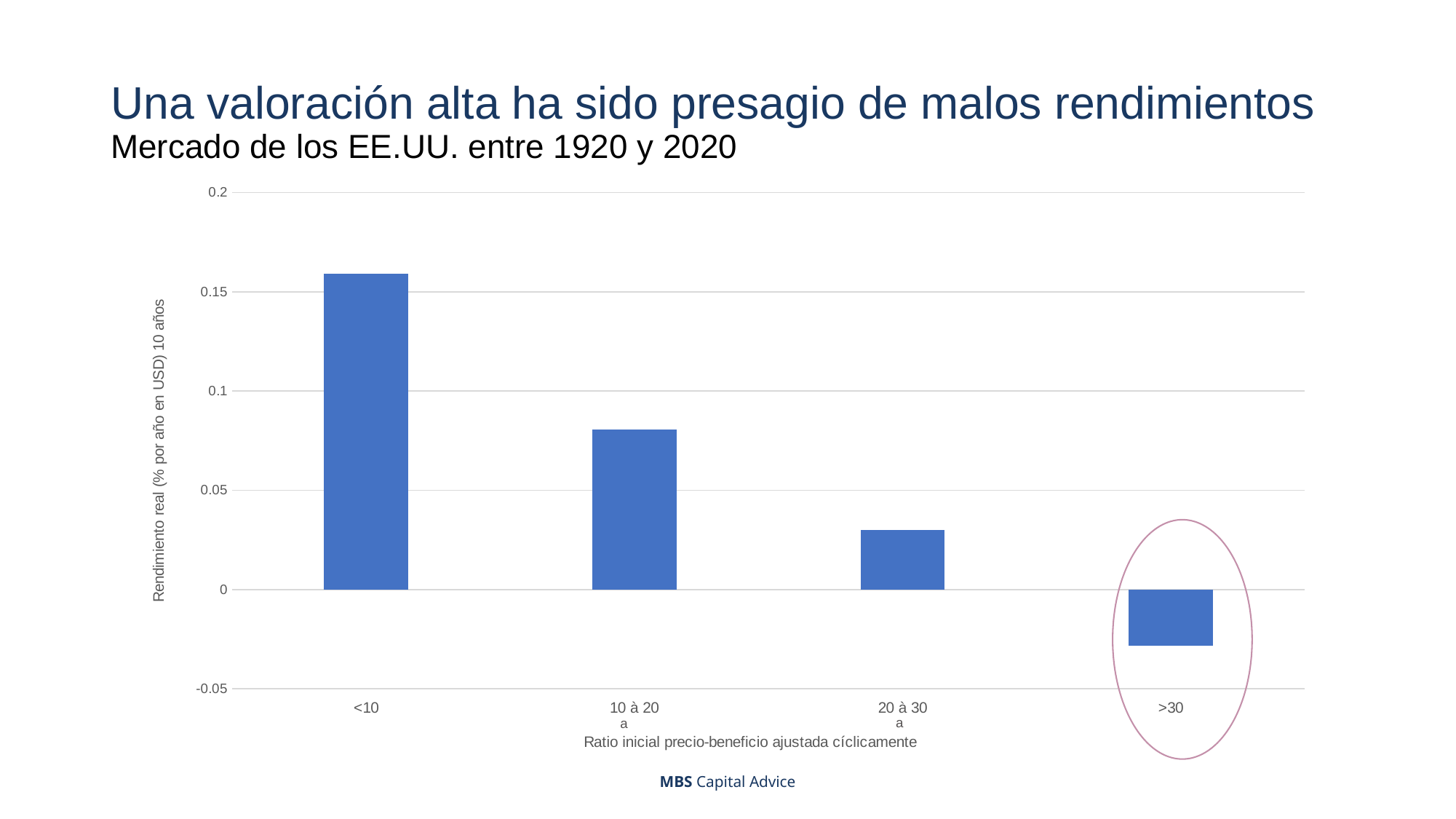
Is the value for 20 à 30 greater or less than 0.05? less What kind of chart is shown on the slide? bar chart Is the value for >30 greater or less than 0? less Which category's bar is circled on the chart? >30 How many categories are plotted on the x axis? 4 Is the value for 10 à 20 greater or less than 0.1? less Do the values rise or fall moving from left to right along the x axis? fall Which category has the lowest value? >30 Which is larger, the value for <10 or the value for 10 à 20? <10 Which category has the highest value? <10 What is the title of the x axis? Ratio inicial precio-beneficio ajustada cíclicamente